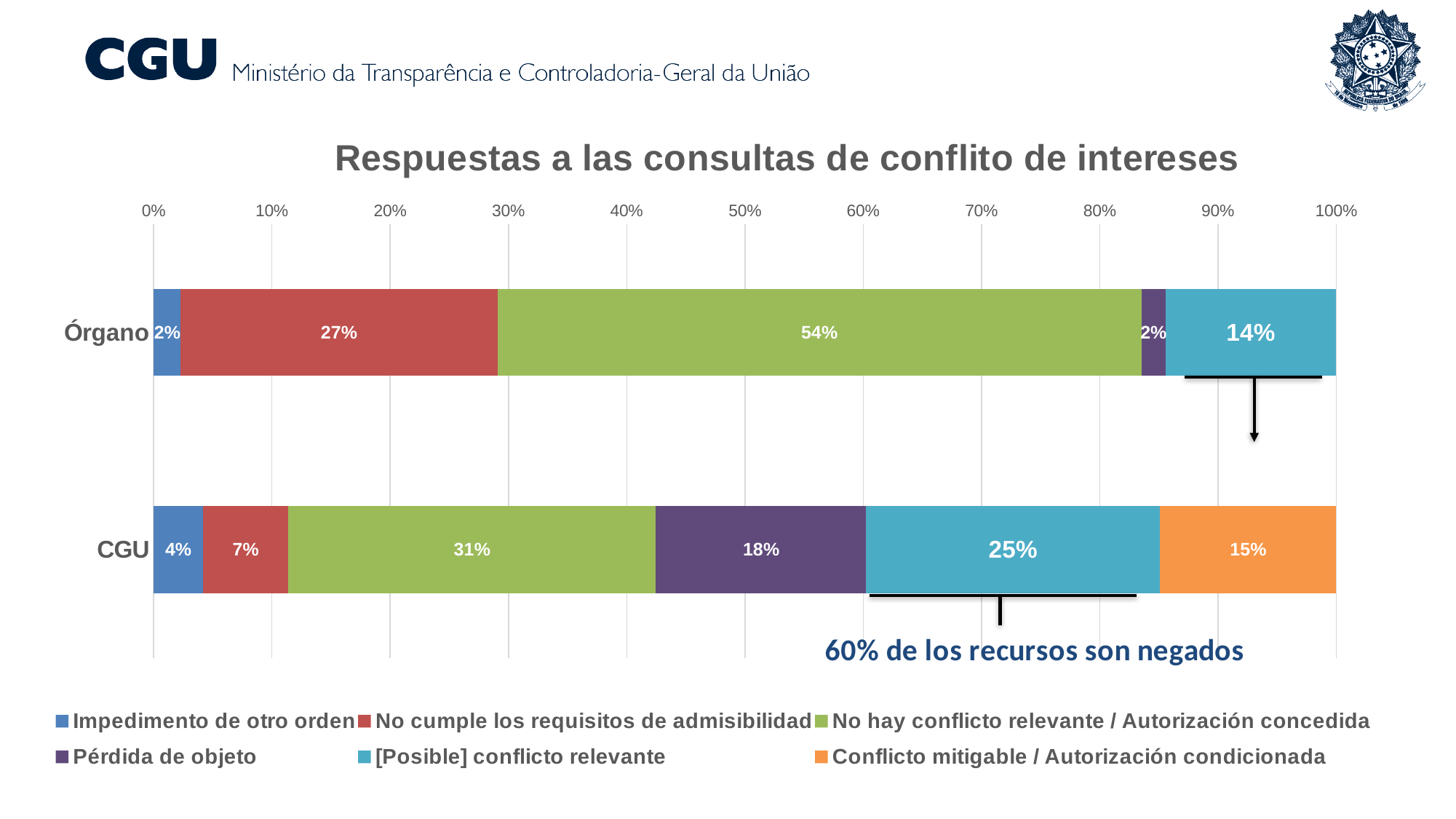
What is the value for 'Conflicto mitigable / Autorización condicionada' in the CGU bar? 15% What is the title of the chart? Respuestas a las consultas de conflito de intereses What is the value for '[Posible] conflicto relevante' in the CGU bar? 25% What is the value for 'No hay conflicto relevante / Autorización concedida' in the Órgano bar? 54% What is the value for 'No cumple los requisitos de admisibilidad' in the Órgano bar? 27% How many series does the legend list? 6 What is the value for 'Pérdida de objeto' in the CGU bar? 18% Which segment is the largest in the CGU bar? No hay conflicto relevante / Autorización concedida Which is larger: 'No cumple los requisitos de admisibilidad' for Órgano or for CGU? Órgano How many categories (bars) are plotted on the chart? 2 What kind of chart is shown on the slide? Stacked bar chart What is the difference between the '[Posible] conflicto relevante' values for CGU and Órgano? 11%